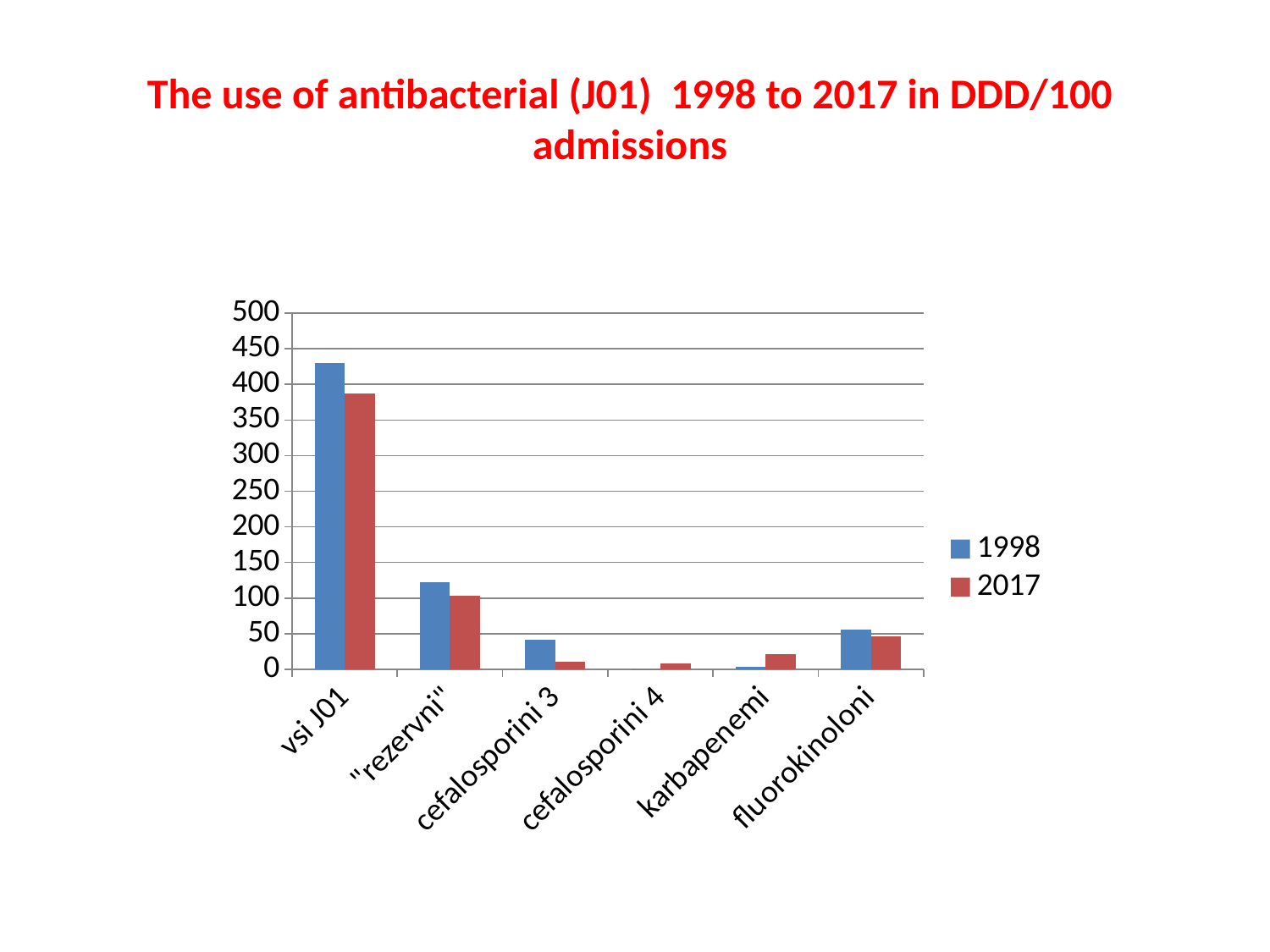
For cefalosporini 3, which series has the larger value, 1998 or 2017? 1998 How many series does the legend list? 2 What are the two entries listed in the chart legend? 1998 and 2017 Is the 1998 value for vsi J01 greater or less than 400? greater Is the 2017 value for vsi J01 greater or less than 350? greater What kind of chart is shown on the slide? bar chart Which category has the highest value for the 1998 series? vsi J01 Is the 1998 value for "rezervni" greater or less than 100? greater Which category has the lowest value for the 1998 series? cefalosporini 4 For karbapenemi, which series has the larger value, 1998 or 2017? 2017 How many categories are shown on the x axis of the chart? 6